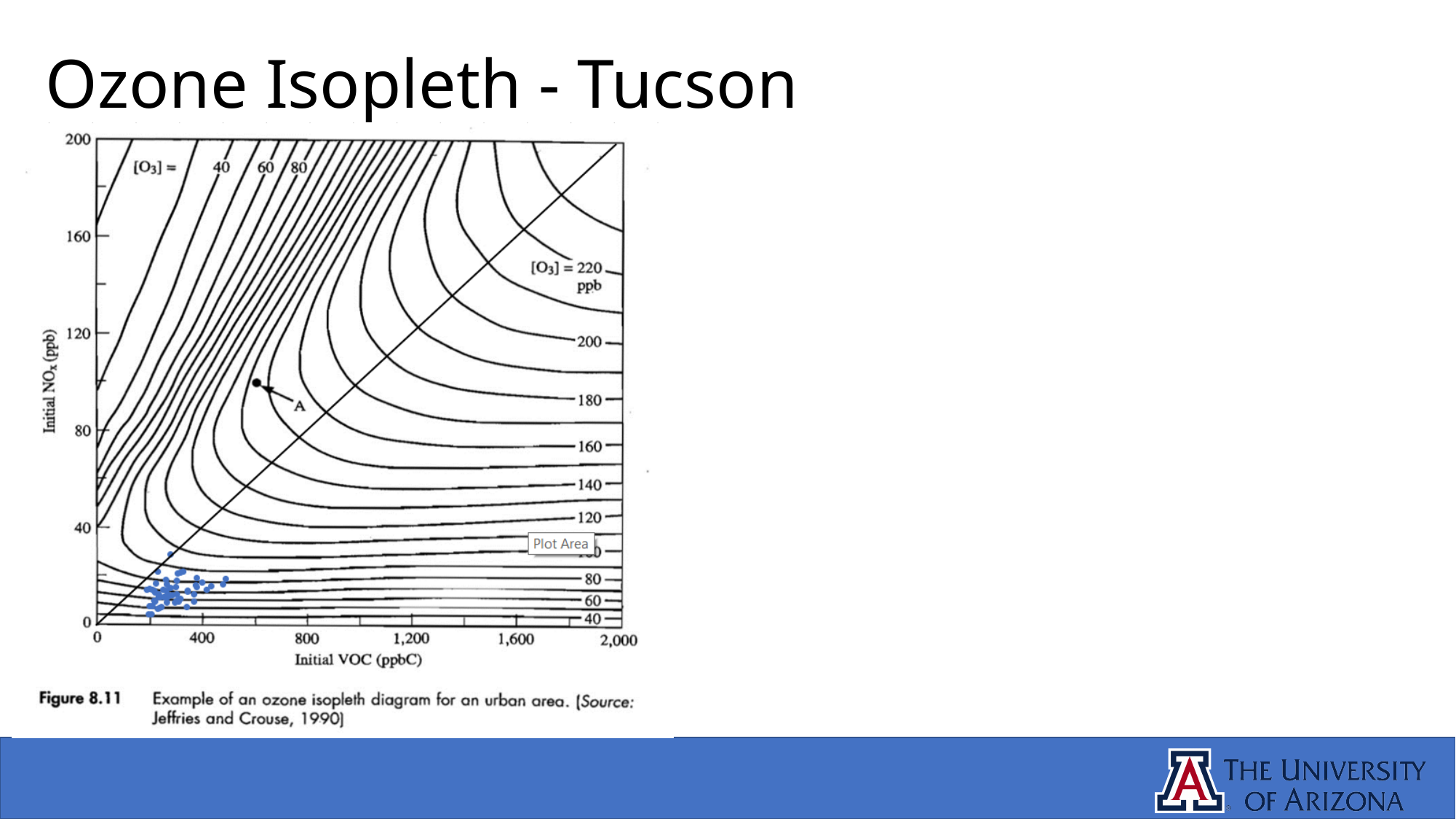
What is the maximum value shown on the x axis of the chart? 2,000 How many tick labels are shown on the x axis of the chart? 6 Is the Initial NOx value of point A greater or less than 80 ppb? greater Are the Initial NOx values of the blue data points greater or less than 40 ppb? less What is the label of the x axis of the ozone isopleth chart? Initial VOC (ppbC) What is the maximum value shown on the y axis of the chart? 200 Are the Initial VOC values of the blue data points greater or less than 800 ppbC? less What is the highest ozone concentration labelled on an isopleth in the chart? 220 ppb What source is cited in the figure caption below the chart? Jeffries and Crouse, 1990 What is the lowest ozone concentration labelled on an isopleth in the chart? 40 What kind of chart is shown on the slide? A scatter plot overlaid on a contour (isopleth) diagram